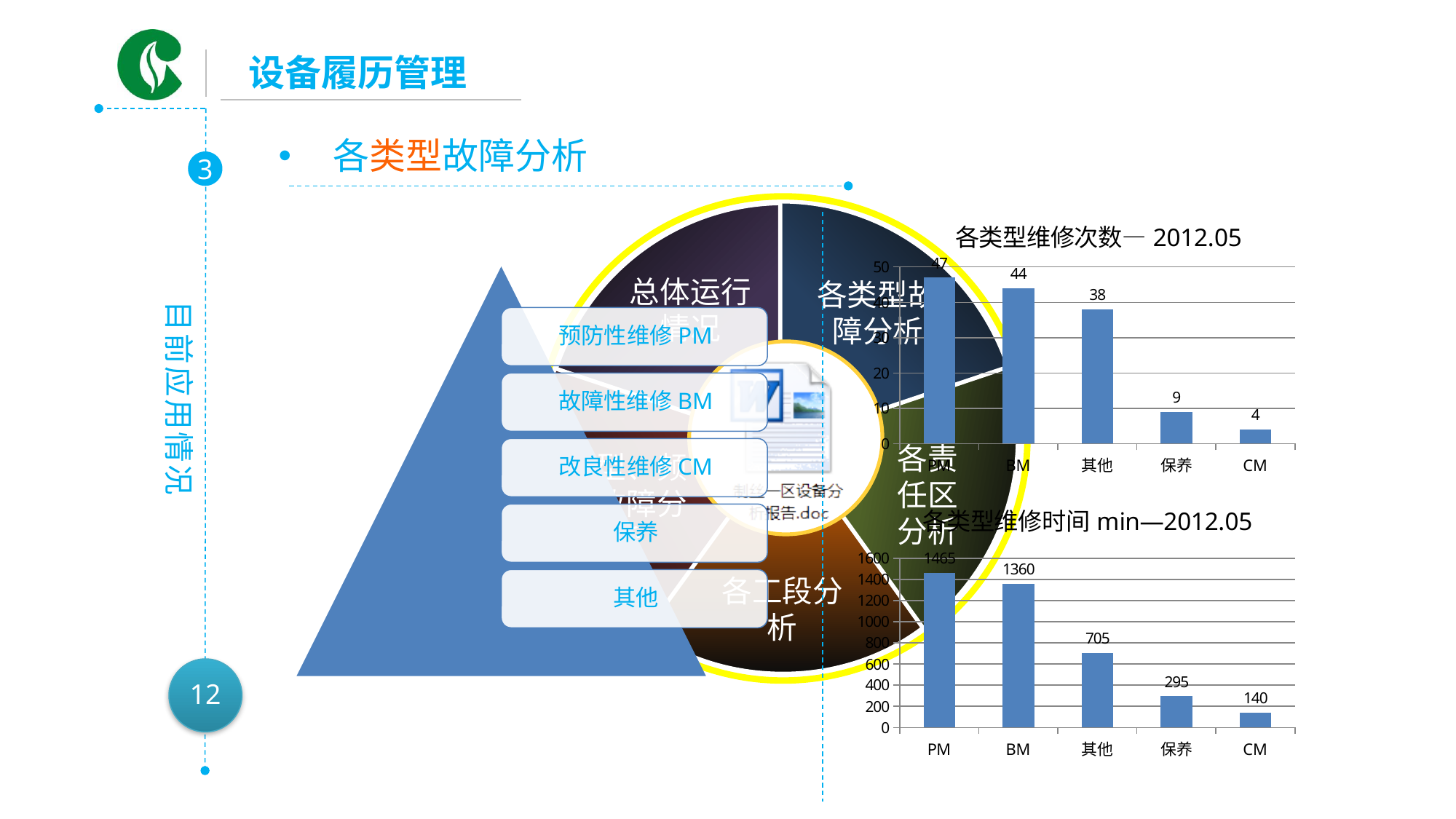
In the chart titled 各类型维修时间 min—2012.05, which category has the highest value? PM What kind of chart is the one titled 各类型维修时间 min—2012.05? bar chart In the chart titled 各类型维修次数— 2012.05, what is the difference between the values for PM and BM? 3 In the chart titled 各类型维修时间 min—2012.05, do the values rise or fall from PM to CM along the x axis? fall In the chart titled 各类型维修时间 min—2012.05, which is larger, the value for 其他 or the value for CM? 其他 In the chart titled 各类型维修时间 min—2012.05, what is the value for BM? 1360 In the chart titled 各类型维修次数— 2012.05, what is the value for 其他? 38 In the chart titled 各类型维修次数— 2012.05, which category has the lowest value? CM In the chart titled 各类型维修时间 min—2012.05, what is the difference between the values for 其他 and CM? 565 In the chart titled 各类型维修时间 min—2012.05, what is the value for 保养? 295 In the chart titled 各类型维修次数— 2012.05, how many categories are shown on the x axis? 5 In the chart titled 各类型维修次数— 2012.05, what is the value for PM? 47